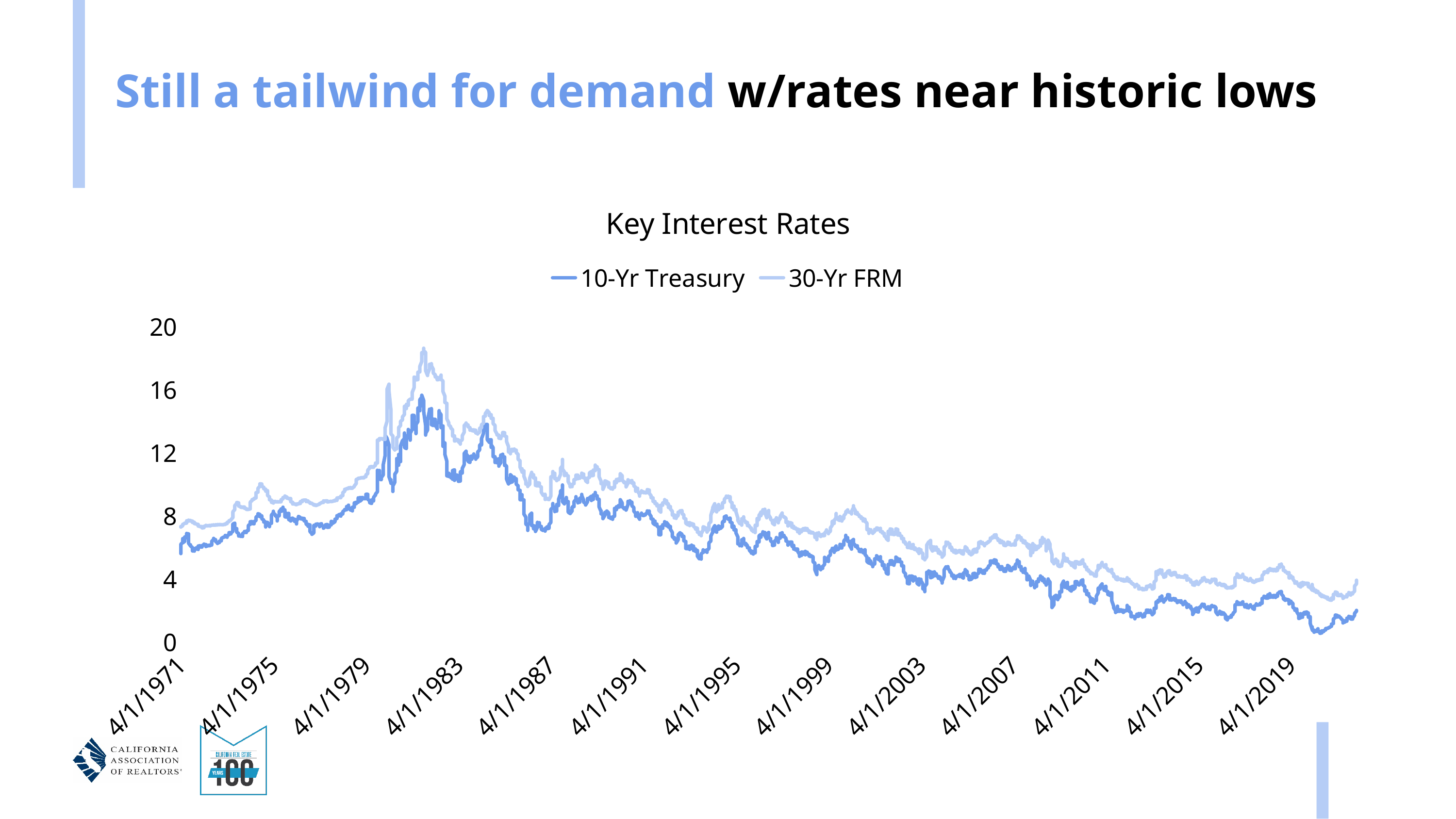
Is the peak value of the 30-Yr FRM series greater or less than 16? greater How many series does the legend of the Key Interest Rates chart list? 2 How many date labels are shown on the x axis? 13 Is the 30-Yr FRM value at 4/1/1971 greater or less than 8? less Is the 10-Yr Treasury value at 4/1/2019 greater or less than 4? less Do the interest rates generally rise or fall from 4/1/1983 to 4/1/2019? fall At 4/1/2019, which series has the higher value, 10-Yr Treasury or 30-Yr FRM? 30-Yr FRM Which two series are listed in the chart legend? 10-Yr Treasury and 30-Yr FRM Which series reaches the highest value on the chart? 30-Yr FRM What kind of chart is shown on the slide? line chart What is the title of the chart? Key Interest Rates